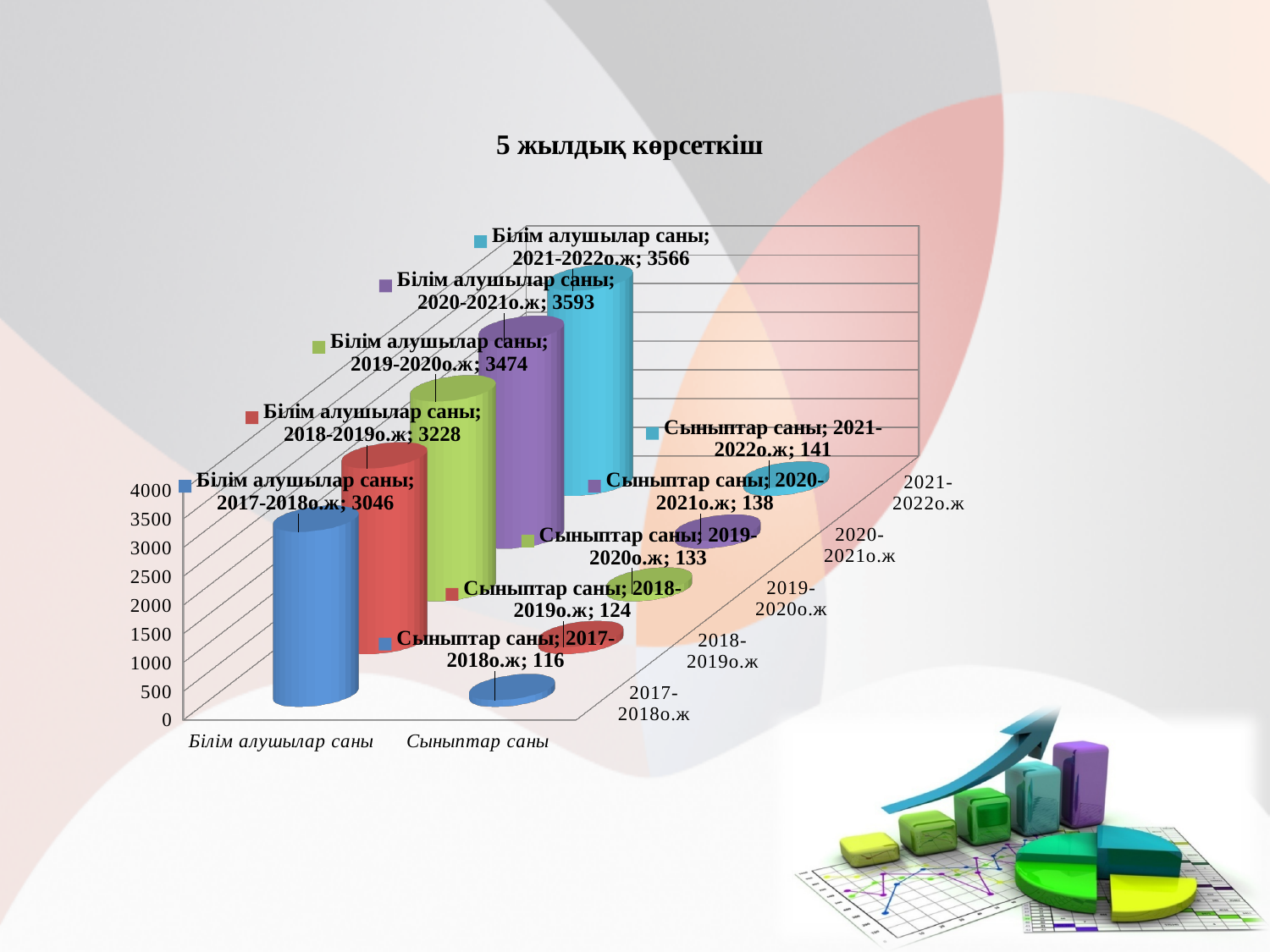
What is the value for Сыныптар саны in 2021-2022о.ж? 141 Which is larger: Білім алушылар саны in 2019-2020о.ж or in 2018-2019о.ж? 2019-2020о.ж In which school year is Білім алушылар саны highest? 2020-2021о.ж What is the value for Білім алушылар саны in 2017-2018о.ж? 3046 How many school years are plotted in the chart? 5 What is the value for Сыныптар саны in 2019-2020о.ж? 133 What type of chart is shown on the slide? bar chart What is the title of the chart? 5 жылдық көрсеткіш In which school year is Сыныптар саны lowest? 2017-2018о.ж What is the value for Білім алушылар саны in 2020-2021о.ж? 3593 What is the difference between Білім алушылар саны in 2021-2022о.ж and in 2017-2018о.ж? 520 Does Сыныптар саны rise or fall from 2017-2018о.ж to 2021-2022о.ж? rise